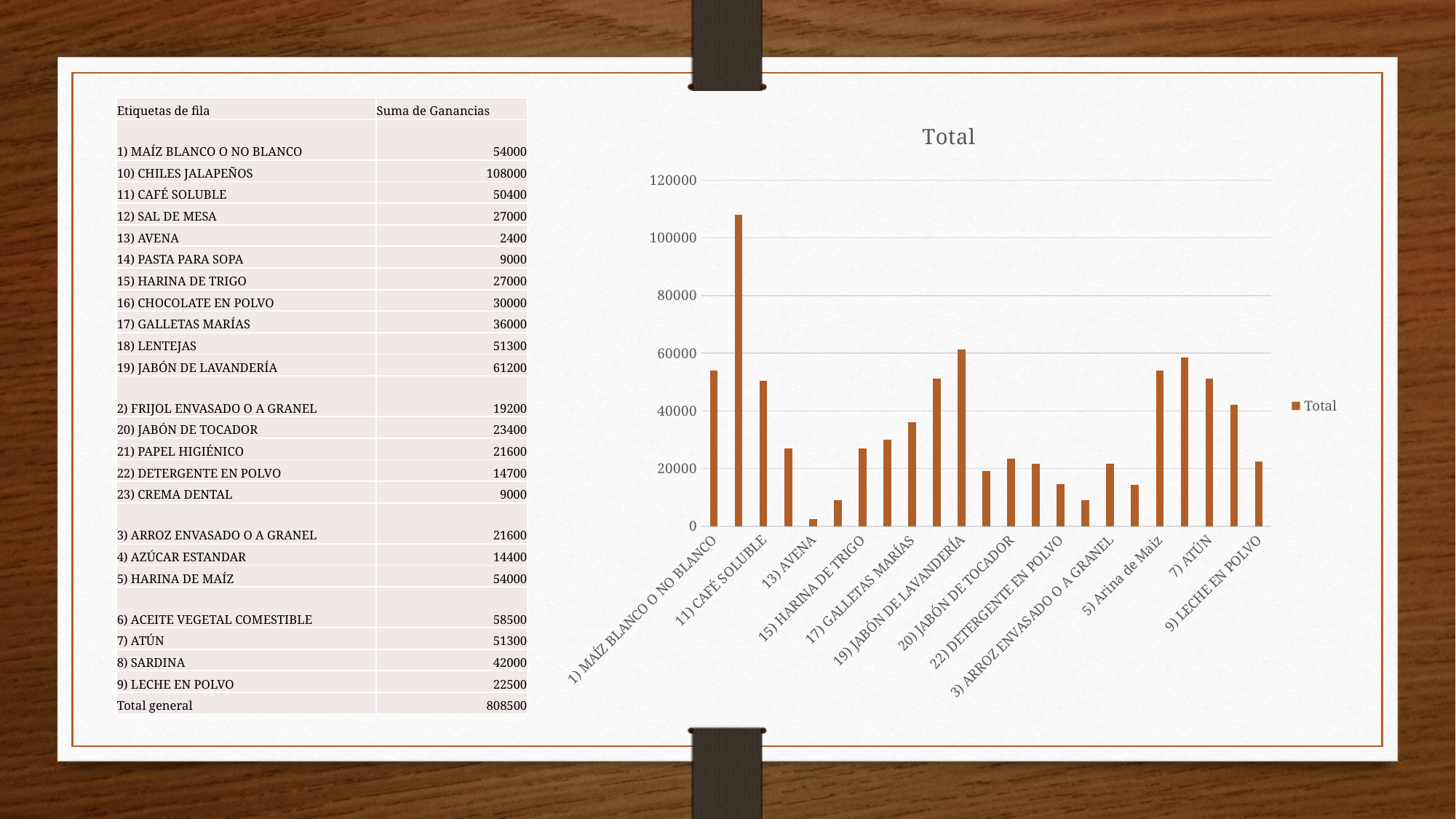
What is the title of the chart? Total Is the value for 7) ATÚN greater or less than 40000? greater How many bars are plotted in the chart? 23 Is the value for 22) DETERGENTE EN POLVO greater or less than 20000? less What kind of chart is shown on the slide? bar chart Which is larger, the value for 17) GALLETAS MARÍAS or the value for 15) HARINA DE TRIGO? 17) GALLETAS MARÍAS Which category has the highest bar in the chart? 10) CHILES JALAPEÑOS Which category has the lowest bar in the chart? 13) AVENA According to the table on the slide, what is the Suma de Ganancias for 19) JABÓN DE LAVANDERÍA? 61200 According to the table on the slide, what is the Suma de Ganancias for 13) AVENA? 2400 Using the table values, what is the difference between 10) CHILES JALAPEÑOS and 1) MAÍZ BLANCO O NO BLANCO? 54000 How many series does the chart legend list? 1